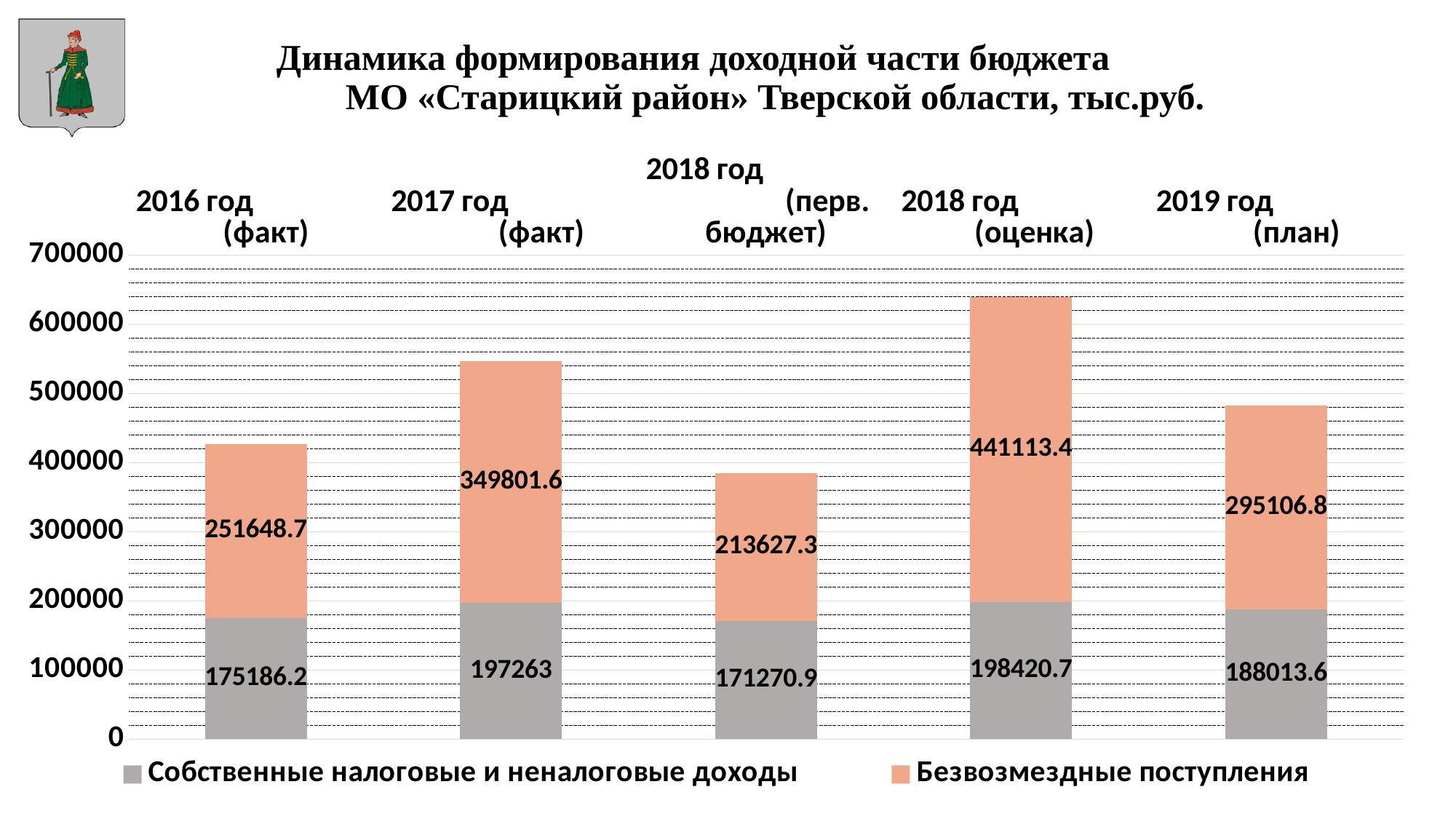
How many categories are shown on the x axis? 5 What is the difference between Безвозмездные поступления for 2018 год (оценка) and for 2016 год (факт)? 189464.7 What is the value of Собственные налоговые и неналоговые доходы for 2017 год (факт)? 197263 Which category has the highest value of Безвозмездные поступления? 2018 год (оценка) What kind of chart is shown on the slide? Stacked bar chart Is the total stacked bar for 2017 год (факт) greater or less than 500000? greater Which category has the lowest value of Собственные налоговые и неналоговые доходы? 2018 год (перв. бюджет) How many series does the legend list? 2 What is the value of Безвозмездные поступления for 2019 год (план)? 295106.8 What is the total of the stacked bar for 2018 год (перв. бюджет)? 384898.2 What is the value of Безвозмездные поступления for 2018 год (оценка)? 441113.4 Which is larger: Собственные налоговые и неналоговые доходы for 2019 год (план) or for 2016 год (факт)? 2019 год (план)